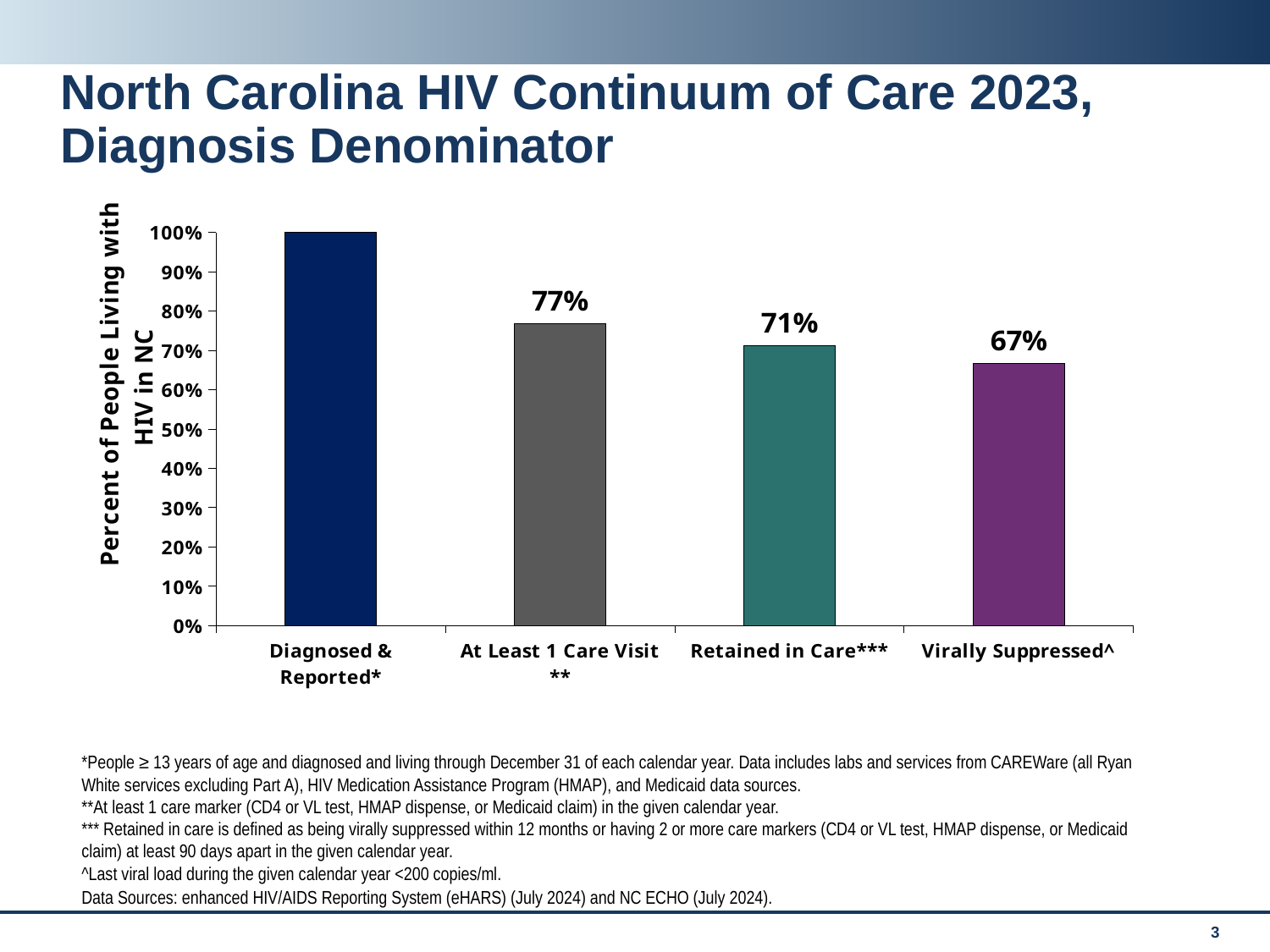
What is the value for Retained in Care? 71% What kind of chart is shown? Bar chart Which is larger, Retained in Care or Virally Suppressed? Retained in Care How many categories are shown on the x axis? 4 Which category has the highest value? Diagnosed & Reported Which category has the lowest value? Virally Suppressed What is the value for Virally Suppressed? 67% What is the difference between At Least 1 Care Visit and Retained in Care? 6% What is the value for Diagnosed & Reported? 100% What is the value for At Least 1 Care Visit? 77% Do the values rise or fall from left to right along the x axis? Fall What is the difference between At Least 1 Care Visit and Virally Suppressed? 10%